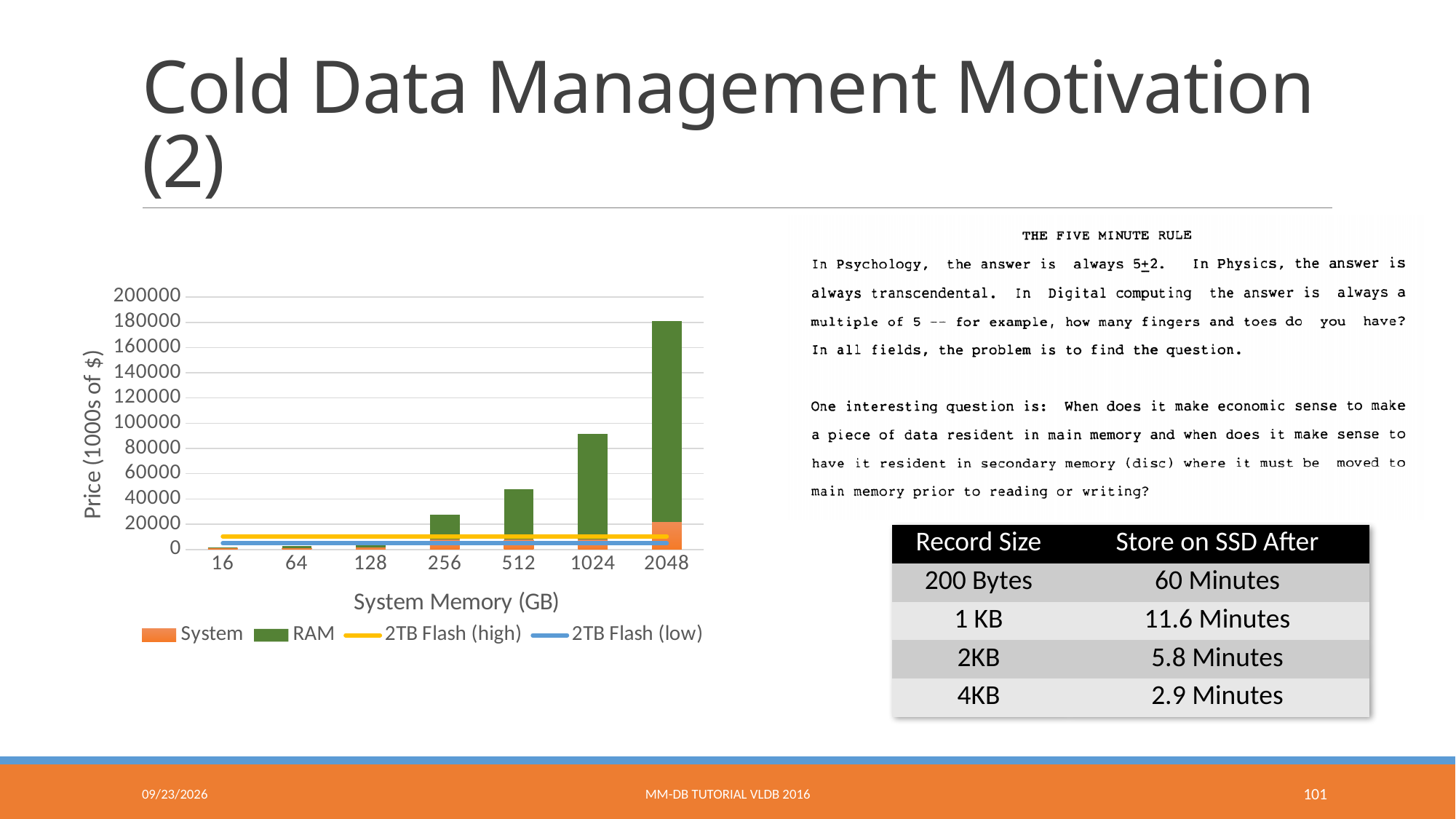
At which system memory size is the RAM price highest? 2048 Is the total stacked bar value for 2048 GB greater or less than 160000? greater What kind of chart is shown on the slide? combination bar and line chart How many series does the chart's legend list? 4 Is the total stacked bar value for 1024 GB greater or less than 100000? less Which has a larger RAM price, 1024 GB or 512 GB? 1024 Is the total stacked bar value for 512 GB greater or less than 40000? greater Does the RAM price rise or fall as system memory increases along the x axis? rise How many system memory categories are shown on the x axis of the chart? 7 What is the label of the chart's y axis? Price (1000s of $) At which system memory size is the RAM price lowest? 16